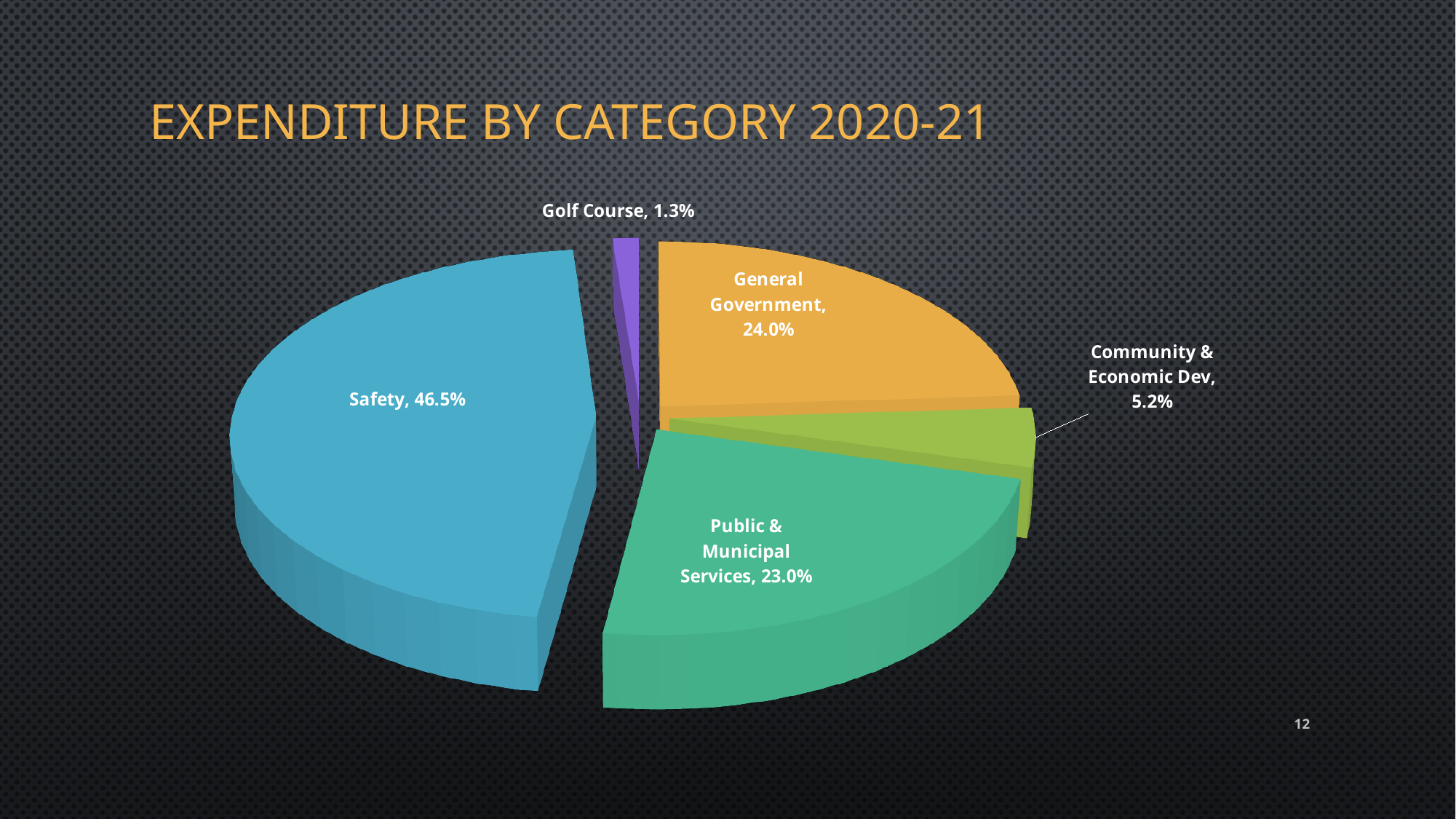
What share of expenditure goes to Safety? 46.5% What kind of chart is shown on the slide? Pie chart What percentage of expenditure is for General Government? 24.0% What is the title of the chart? Expenditure by Category 2020-21 What share does Public & Municipal Services have? 23.0% What is the percentage for Community & Economic Dev? 5.2% Which category has the largest share of expenditure? Safety What share of expenditure is for the Golf Course? 1.3% How many percentage points larger is Safety than General Government? 22.5 Which is larger, General Government or Public & Municipal Services? General Government Which category has the smallest share of expenditure? Golf Course How many categories are shown in the pie chart? 5